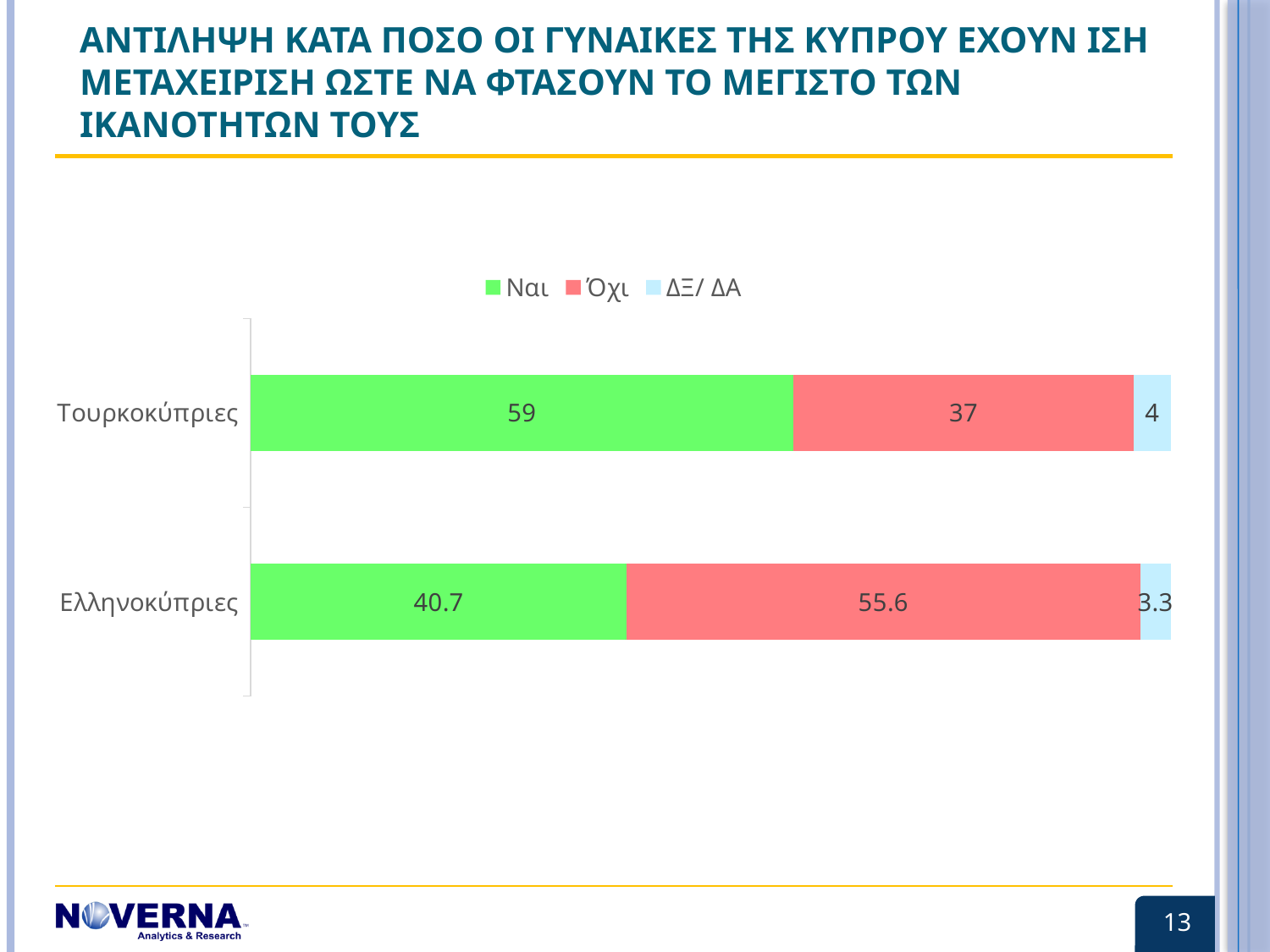
Which category has the lower value for Όχι? Τουρκοκύπριες Is the Ναι value for Ελληνοκύπριες larger or smaller than the Όχι value for Ελληνοκύπριες? smaller What is the value for Ναι for Ελληνοκύπριες? 40.7 How many series does the legend list? 3 What is the value for Ναι for Τουρκοκύπριες? 59 What is the total of the stacked bar for Ελληνοκύπριες? 99.6 What is the difference between the Όχι values for Ελληνοκύπριες and Τουρκοκύπριες? 18.6 What is the value for ΔΞ/ ΔΑ for Τουρκοκύπριες? 4 What is the value for Όχι for Ελληνοκύπριες? 55.6 Which category has the higher value for Ναι? Τουρκοκύπριες How many categories are shown on the chart? 2 What kind of chart is shown on the slide? stacked bar chart